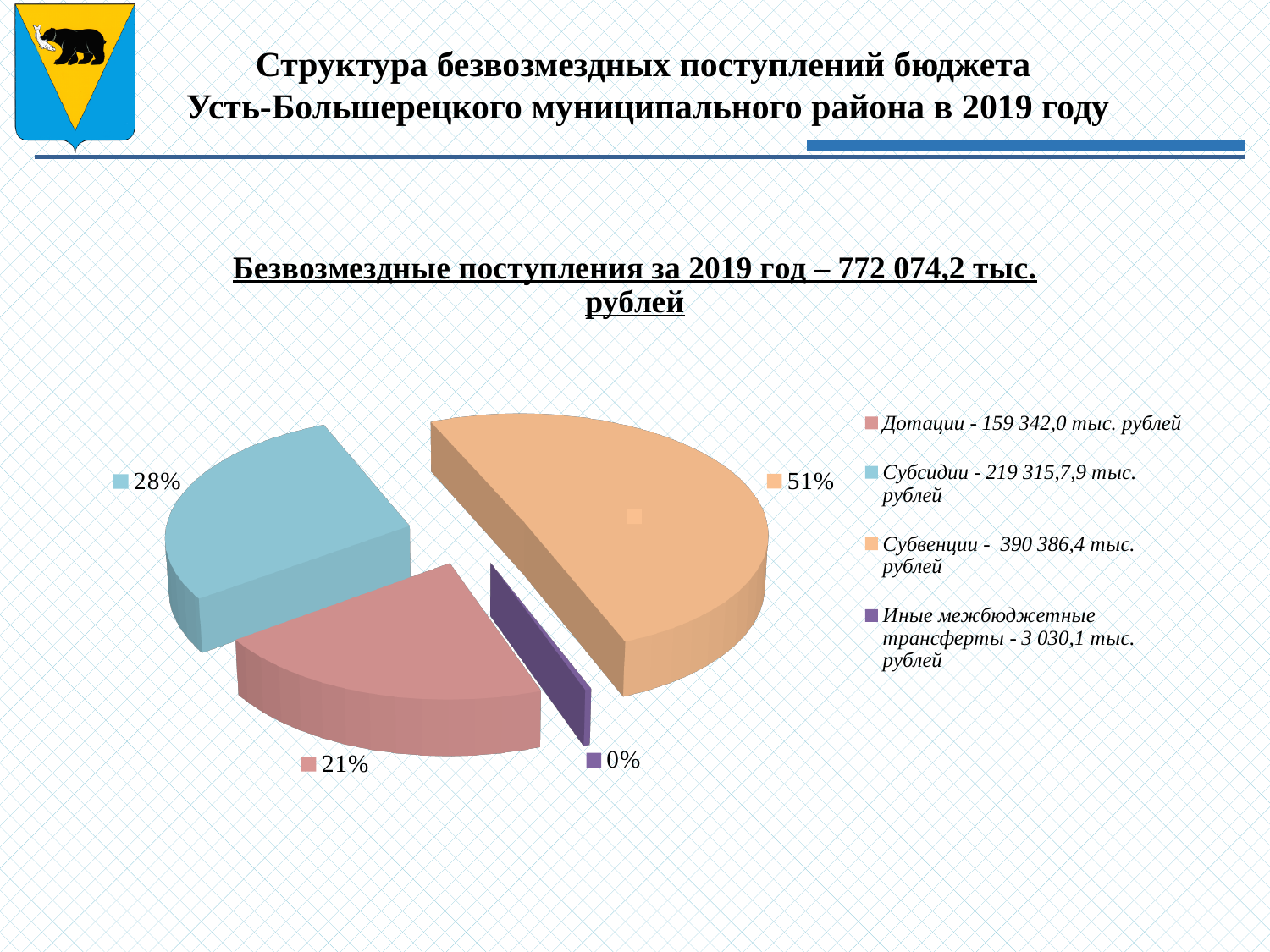
Which category has the largest slice of the pie? Субвенции How many categories are shown in the pie chart? 4 What share of the pie does Субсидии account for? 28% What share of the pie does Иные межбюджетные трансферты account for? 0% According to the legend, what is the amount for Дотации? 159 342,0 тыс. рублей By how many percentage points does the Субвенции share exceed the Субсидии share? 23 percentage points Which category has the smallest slice of the pie? Иные межбюджетные трансферты What total amount of безвозмездные поступления for 2019 is stated in the chart title? 772 074,2 тыс. рублей Which slice is larger, Субсидии or Дотации? Субсидии What share of the pie does Дотации account for? 21% What kind of chart is shown on the slide? Pie chart